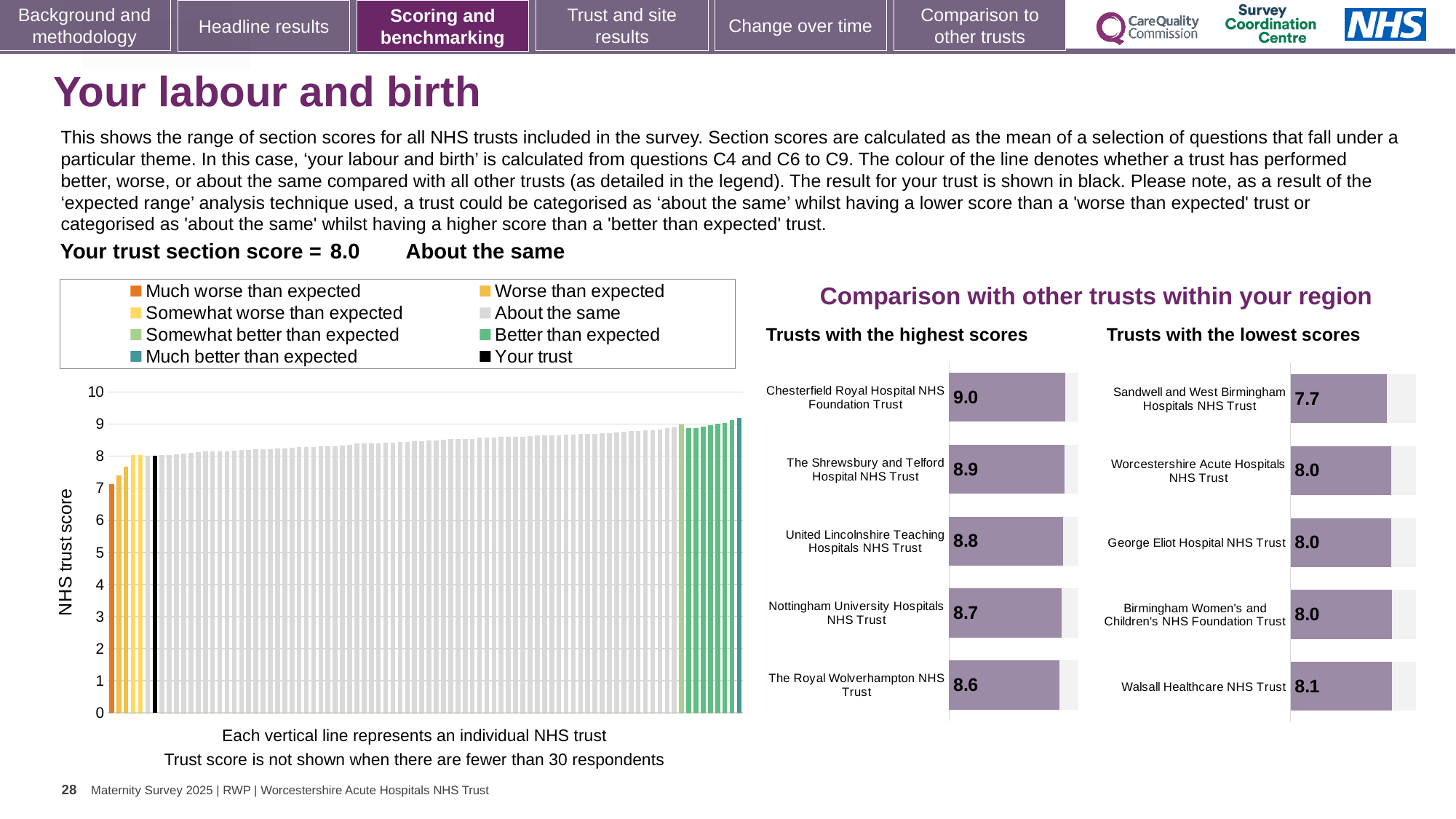
In the 'Trusts with the highest scores' chart, which trust has the highest score? Chesterfield Royal Hospital NHS Foundation Trust In the main 'NHS trust score' chart, is the value of the tallest bar greater or less than 9? greater In the 'Trusts with the lowest scores' chart, what is the score for Walsall Healthcare NHS Trust? 8.1 In the 'Trusts with the highest scores' chart, what is the difference between the scores of Chesterfield Royal Hospital NHS Foundation Trust and Nottingham University Hospitals NHS Trust? 0.3 In the 'Trusts with the lowest scores' chart, which has the larger score: Walsall Healthcare NHS Trust or Sandwell and West Birmingham Hospitals NHS Trust? Walsall Healthcare NHS Trust In the 'Trusts with the highest scores' chart, what is the score for Chesterfield Royal Hospital NHS Foundation Trust? 9.0 In the 'Trusts with the highest scores' chart, what is the score for The Royal Wolverhampton NHS Trust? 8.6 What kind of chart is the main chart with the 'NHS trust score' axis? Bar chart How many entries does the legend of the main 'NHS trust score' chart list? 8 How many trusts are shown in the 'Trusts with the highest scores' chart? 5 In the 'Trusts with the lowest scores' chart, what is the score for Sandwell and West Birmingham Hospitals NHS Trust? 7.7 In the 'Trusts with the lowest scores' chart, which trust has the lowest score? Sandwell and West Birmingham Hospitals NHS Trust